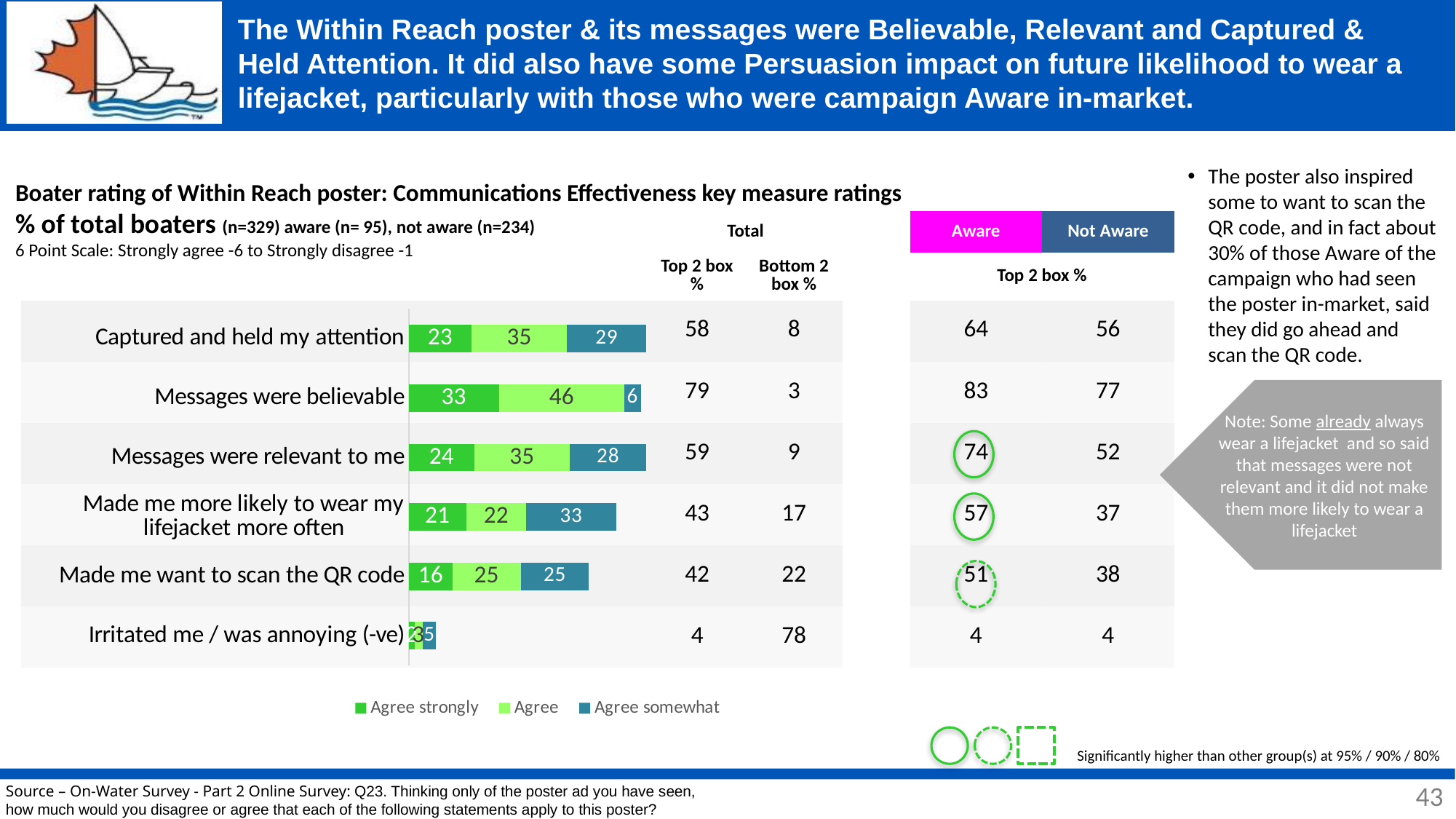
What is the 'Agree' value for 'Captured and held my attention'? 35 What is the 'Agree strongly' value for 'Messages were believable'? 33 Which statement has the lowest 'Agree somewhat' value among the bars with readable labels above 5? Messages were believable Which statement has the highest 'Agree strongly' value? Messages were believable In the Aware column of the Top 2 box % table, what is the value for 'Messages were relevant to me'? 74 What is the total of the stacked bar for 'Messages were believable'? 85 What kind of chart is used to show the boater ratings of the Within Reach poster? bar chart What is the difference between the 'Agree' value for 'Messages were believable' and the 'Agree' value for 'Messages were relevant to me'? 11 How many statements (categories) are rated in the bar chart? 6 How many series does the legend of the bar chart list? 3 What is the 'Agree somewhat' value for 'Made me more likely to wear my lifejacket more often'? 33 Which is larger: the 'Agree somewhat' value for 'Made me more likely to wear my lifejacket more often' or for 'Messages were believable'? Made me more likely to wear my lifejacket more often